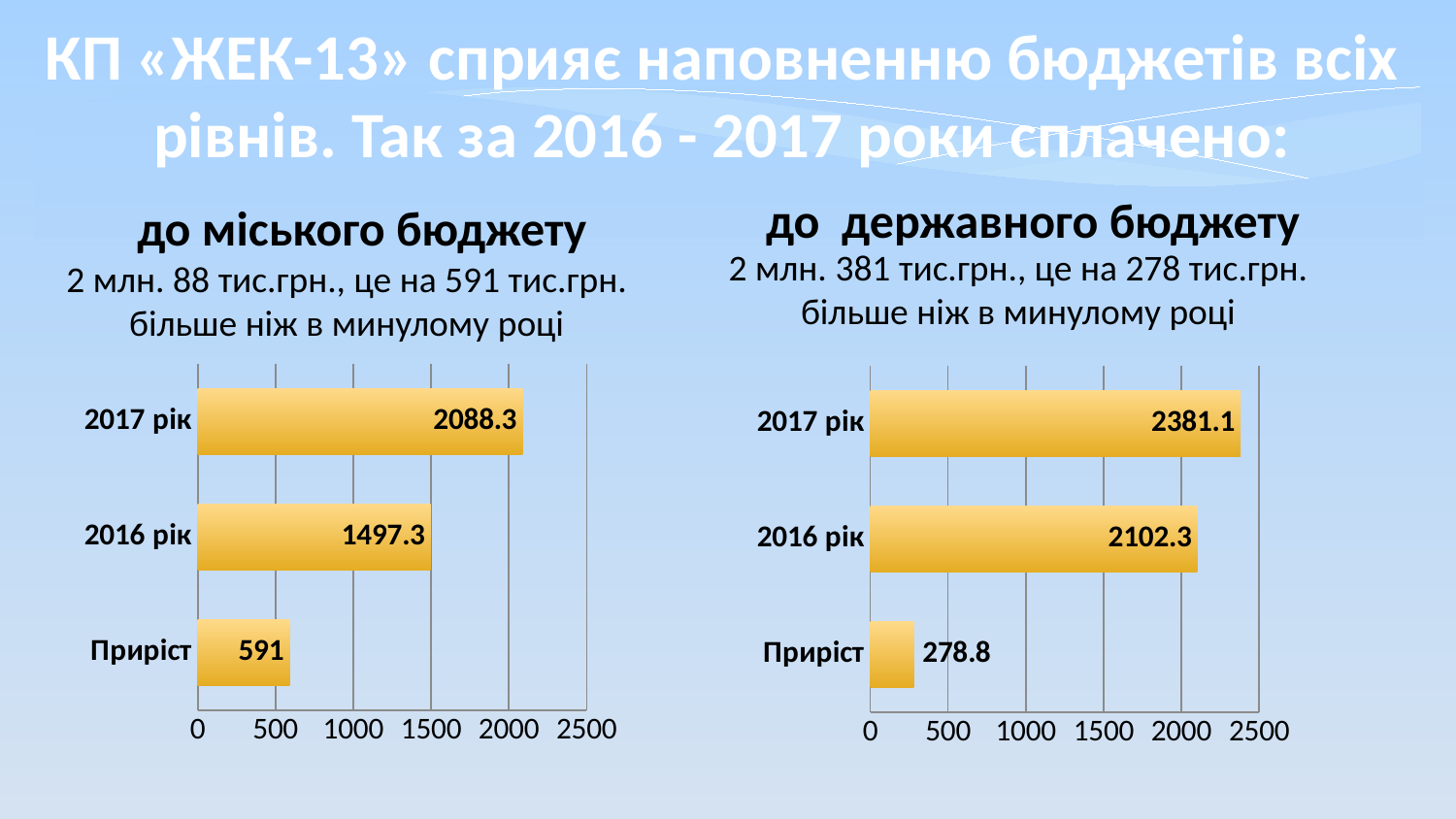
In the left chart (до міського бюджету), what is the difference between the values for 2017 рік and 2016 рік? 591 In the left chart (до міського бюджету), what is the value for 2016 рік? 1497.3 In the right chart (до державного бюджету), what is the value for Приріст? 278.8 In the right chart (до державного бюджету), is the value for 2016 рік greater or less than 2000? greater In the right chart (до державного бюджету), what is the difference between the values for 2017 рік and 2016 рік? 278.8 What type of chart is used on the right side of the slide (до державного бюджету)? bar chart In the left chart (до міського бюджету), which category has the lowest value? Приріст How many bars does the left chart (до міського бюджету) show? 3 Which is larger: the 2016 рік value in the left chart or the 2016 рік value in the right chart? the right chart (2102.3) In the right chart (до державного бюджету), what is the value for 2017 рік? 2381.1 In the right chart (до державного бюджету), which category has the highest value? 2017 рік In the left chart (до міського бюджету), what is the value for 2017 рік? 2088.3